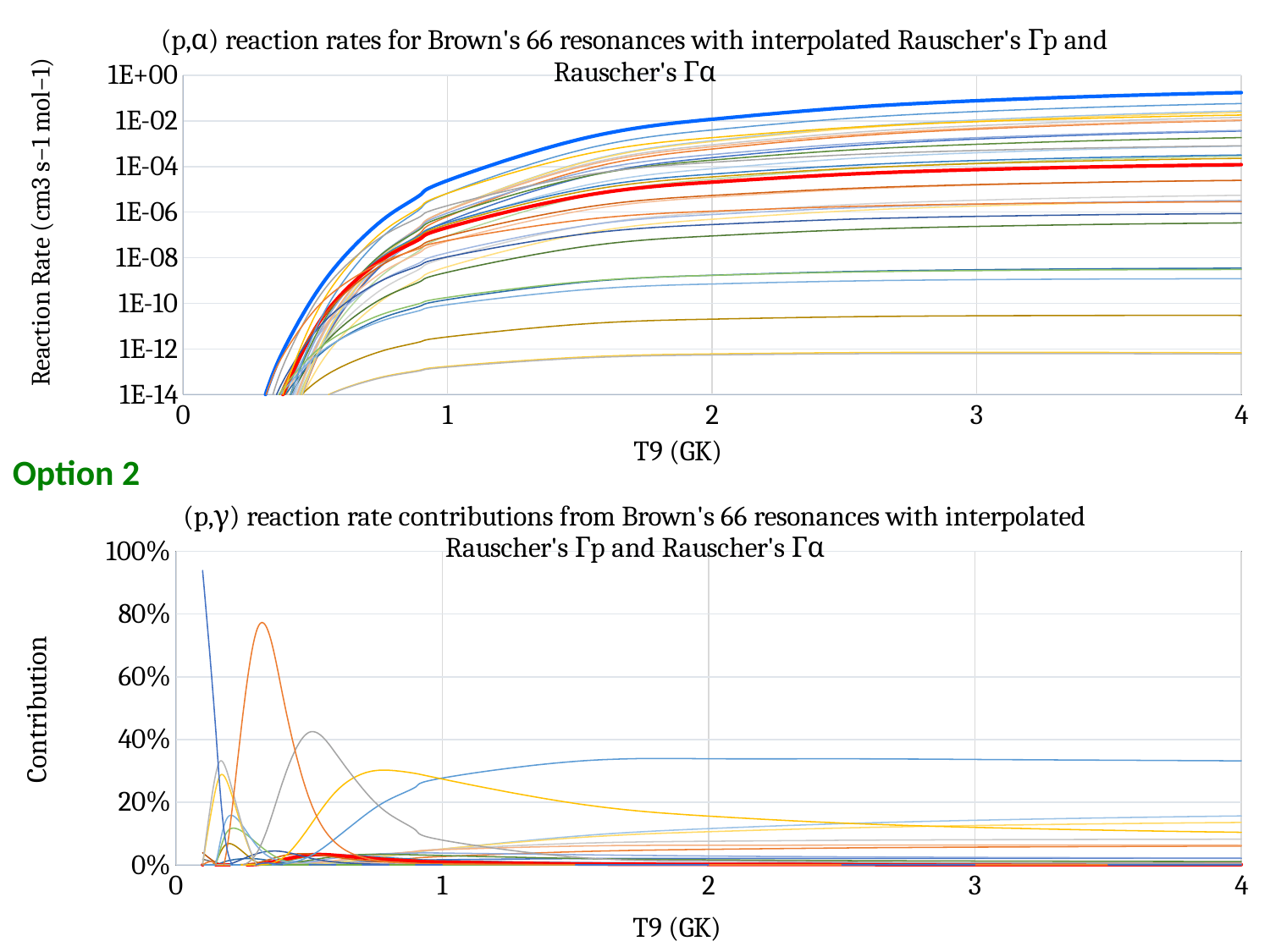
In the top chart, does the thick blue line rise or fall as T9 increases from 1 to 4? Rises In the bottom chart, is the peak of the orange line near T9 = 0.3 greater or less than 60%? greater In the top chart, is the value of the thick red line at T9 = 2 greater or less than 1E-04? less What is the y-axis label of the bottom chart? Contribution What is the x-axis label of the top chart? T9 (GK) In the bottom chart, is the peak of the gray line near T9 = 0.5 greater or less than 60%? less What kind of chart is the bottom chart, titled "(p,γ) reaction rate contributions from Brown's 66 resonances"? Line chart In the bottom chart, does the dark blue line that starts near 95% rise or fall as T9 increases from 0.1 to 0.3? Falls What kind of chart is the top chart, titled "(p,α) reaction rates for Brown's 66 resonances"? Line chart